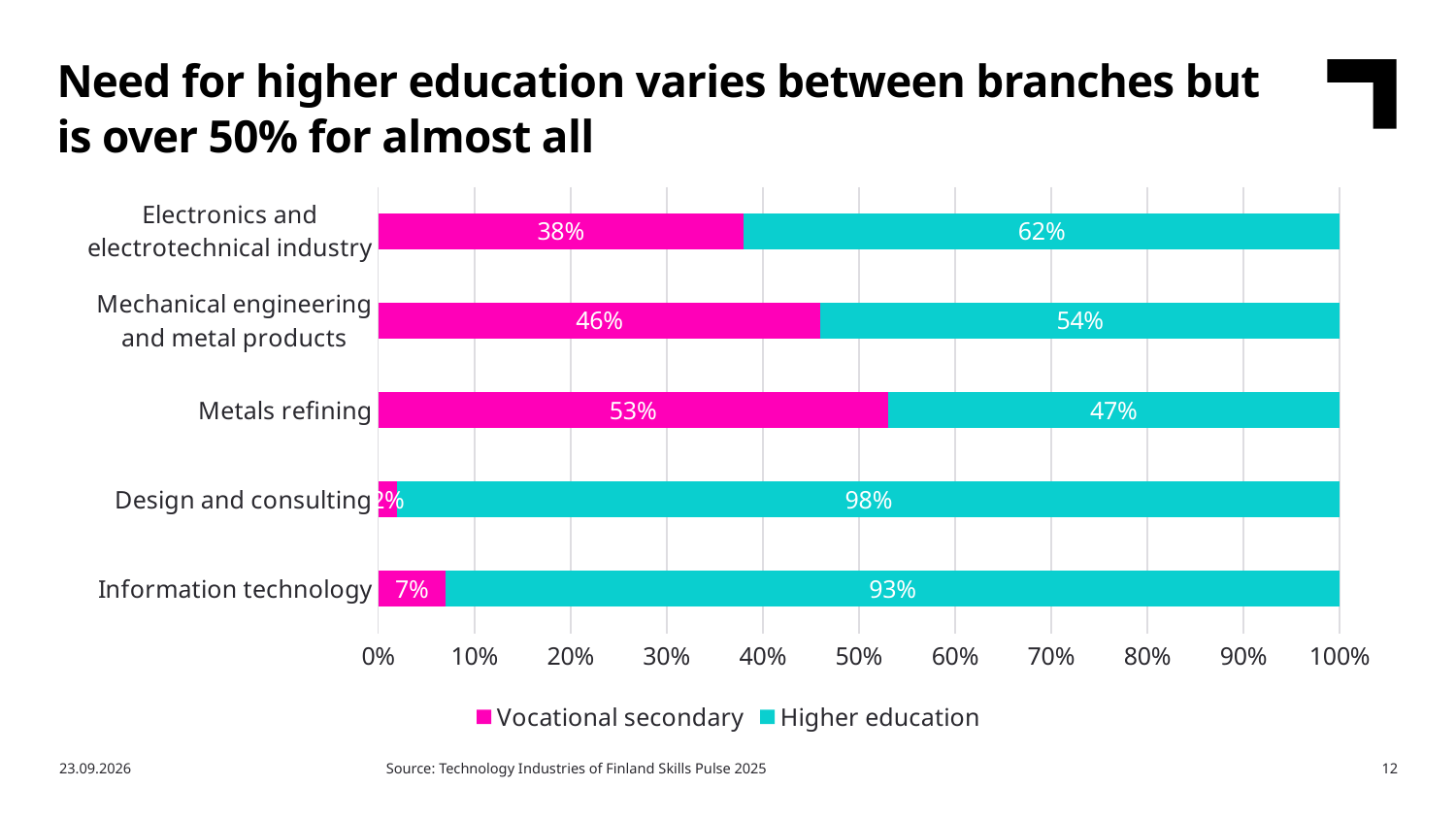
How many branches are shown in the chart? 5 What is the Vocational secondary value for Metals refining? 53% What kind of chart is shown on the slide? Stacked bar chart Which is larger: the Vocational secondary value for Metals refining or for Mechanical engineering and metal products? Metals refining Which colour represents Higher education in the chart? Cyan Which branch has the highest Higher education value? Design and consulting Which branch has the lowest Vocational secondary value? Design and consulting What is the difference between the Higher education values for Design and consulting and Information technology? 5% What is the Higher education value for Electronics and electrotechnical industry? 62% What is the Vocational secondary value for Mechanical engineering and metal products? 46% What is the Higher education value for Information technology? 93% How many series does the legend list? 2